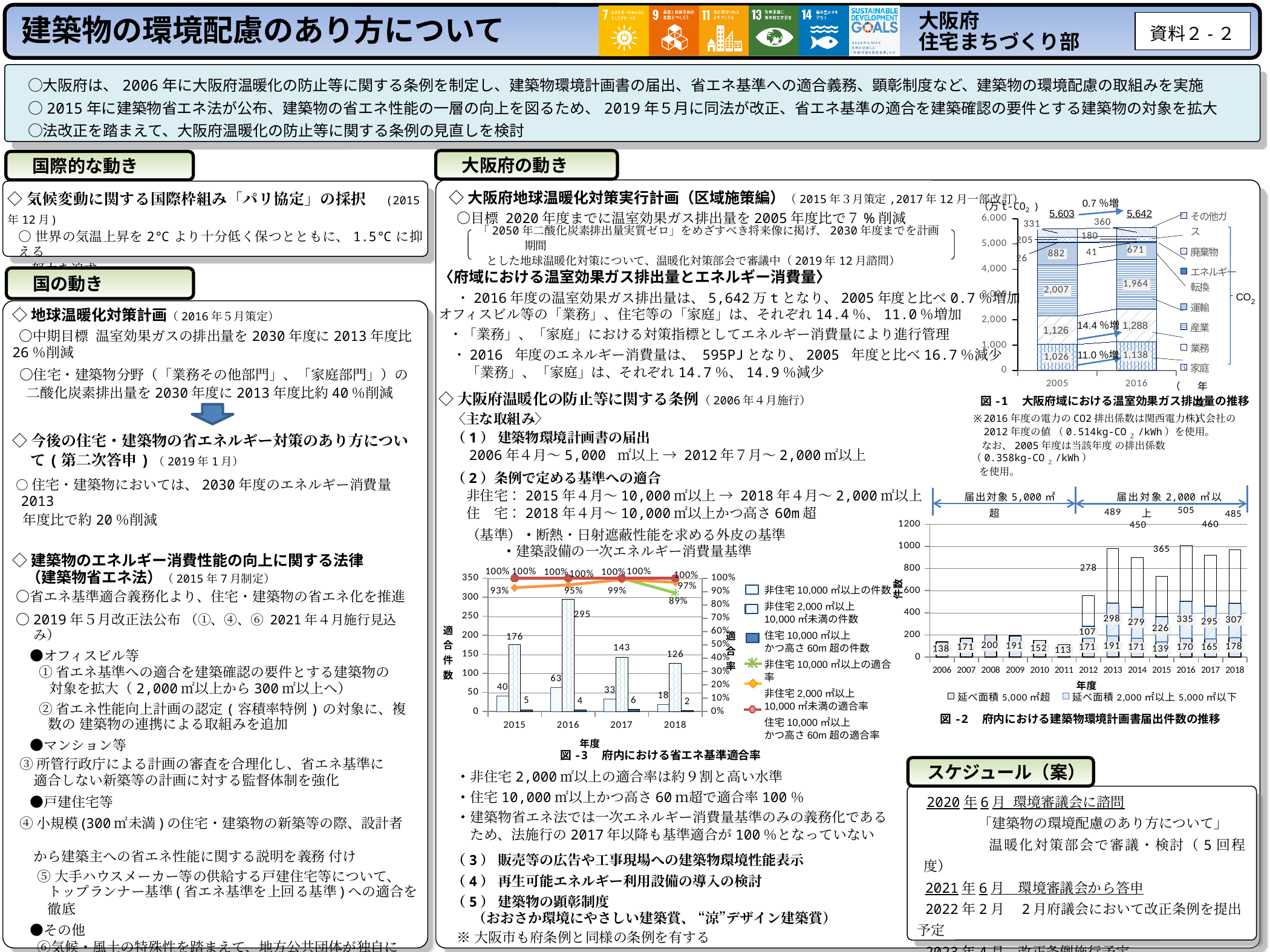
In 図-2 (府内における建築物環境計画書届出件数の推移), what is the 延べ面積2,000㎡以上5,000㎡以下 value for 2016? 335 In 図-3 (府内における省エネ基準適合率), what is the 非住宅 2,000㎡以上10,000㎡未満の件数 value for 2016? 295 In 図-3 (府内における省エネ基準適合率), how many entries does the legend list? 6 In 図-2 (府内における建築物環境計画書届出件数の推移), what is the total number of submissions for 2013? 489 In 図-2 (府内における建築物環境計画書届出件数の推移), which year has the lowest 延べ面積5,000㎡超 value? 2011 In 図-2 (府内における建築物環境計画書届出件数の推移), how many years are shown on the x axis? 13 In 図-1 (大阪府域における温室効果ガス排出量の推移), which year has the larger 運輸 value, 2005 or 2016? 2005 In 図-1 (大阪府域における温室効果ガス排出量の推移), what is the total emissions value shown for 2016? 5,642 In 図-1 (大阪府域における温室効果ガス排出量の推移), what is the difference between the 業務 values for 2016 and 2005? 162 In 図-3 (府内における省エネ基準適合率), what is the 非住宅 10,000㎡以上の適合率 for 2018? 89% In 図-3 (府内における省エネ基準適合率), in which year is the 非住宅 10,000㎡以上の件数 value highest? 2016 In 図-1 (大阪府域における温室効果ガス排出量の推移), what is the 産業 value for 2005? 2,007